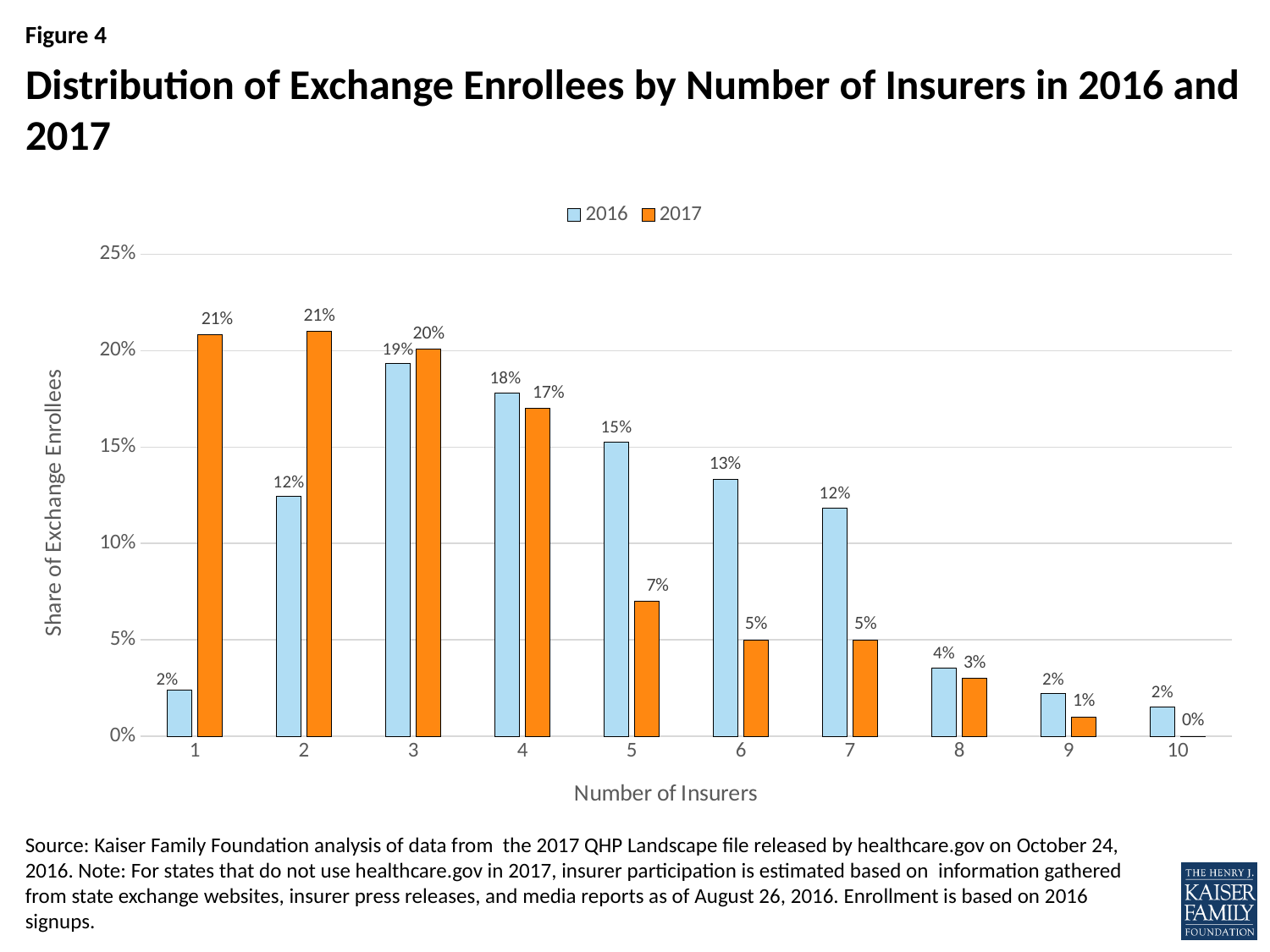
What is the 2017 value for 1 insurer? 21% Which number of insurers has the highest 2016 share of exchange enrollees? 3 How many series does the legend list? 2 How many categories (numbers of insurers) are shown on the x axis? 10 What is the difference between the 2017 and 2016 values for 1 insurer? 19 percentage points What is the 2016 value for 5 insurers? 15% What is the 2017 value for 10 insurers? 0% Do the 2017 values generally rise or fall as the number of insurers increases from 1 to 10? Fall What kind of chart is shown on the slide? Bar chart Which number of insurers has the lowest 2017 share of exchange enrollees? 10 Is the 2016 value for 6 insurers greater or less than 10%? greater For 5 insurers, which year has the larger share of exchange enrollees, 2016 or 2017? 2016